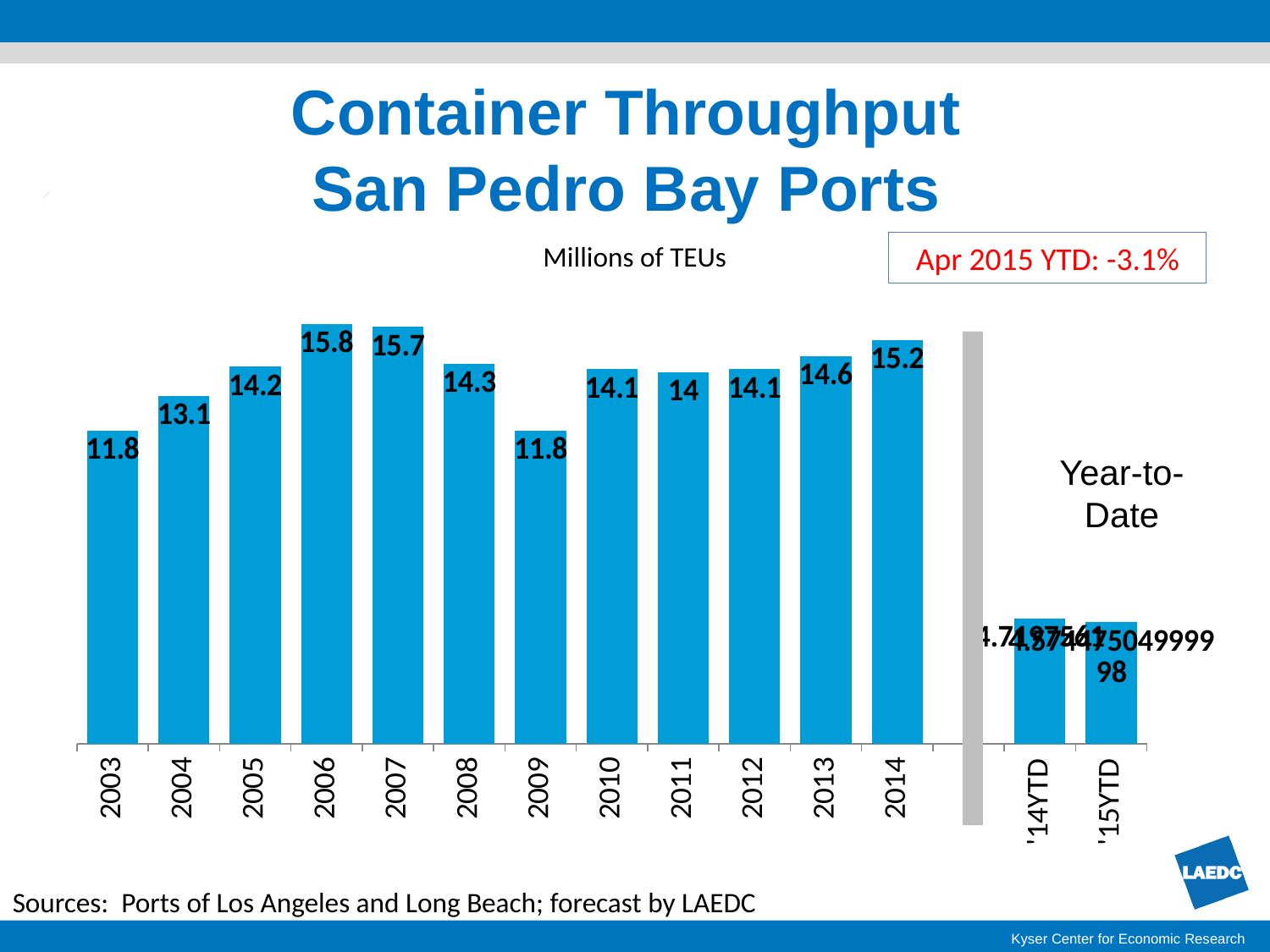
How many annual bars (2003 through 2014) are shown in the chart? 12 What is the difference between the values for 2014 and 2013? 0.6 Which year has the highest container throughput? 2006 What is the value shown for 2011? 14 What is the value shown for 2009? 11.8 Which is larger, the value for 2013 or the value for 2012? 2013 What unit is the chart measured in, according to the subtitle? Millions of TEUs Do the values rise or fall from 2007 to 2009? Fall What is the container throughput value shown for 2006? 15.8 What is the value shown for 2014? 15.2 What is the difference between the values for 2006 and 2009? 4 What kind of chart is shown on the slide? Bar chart